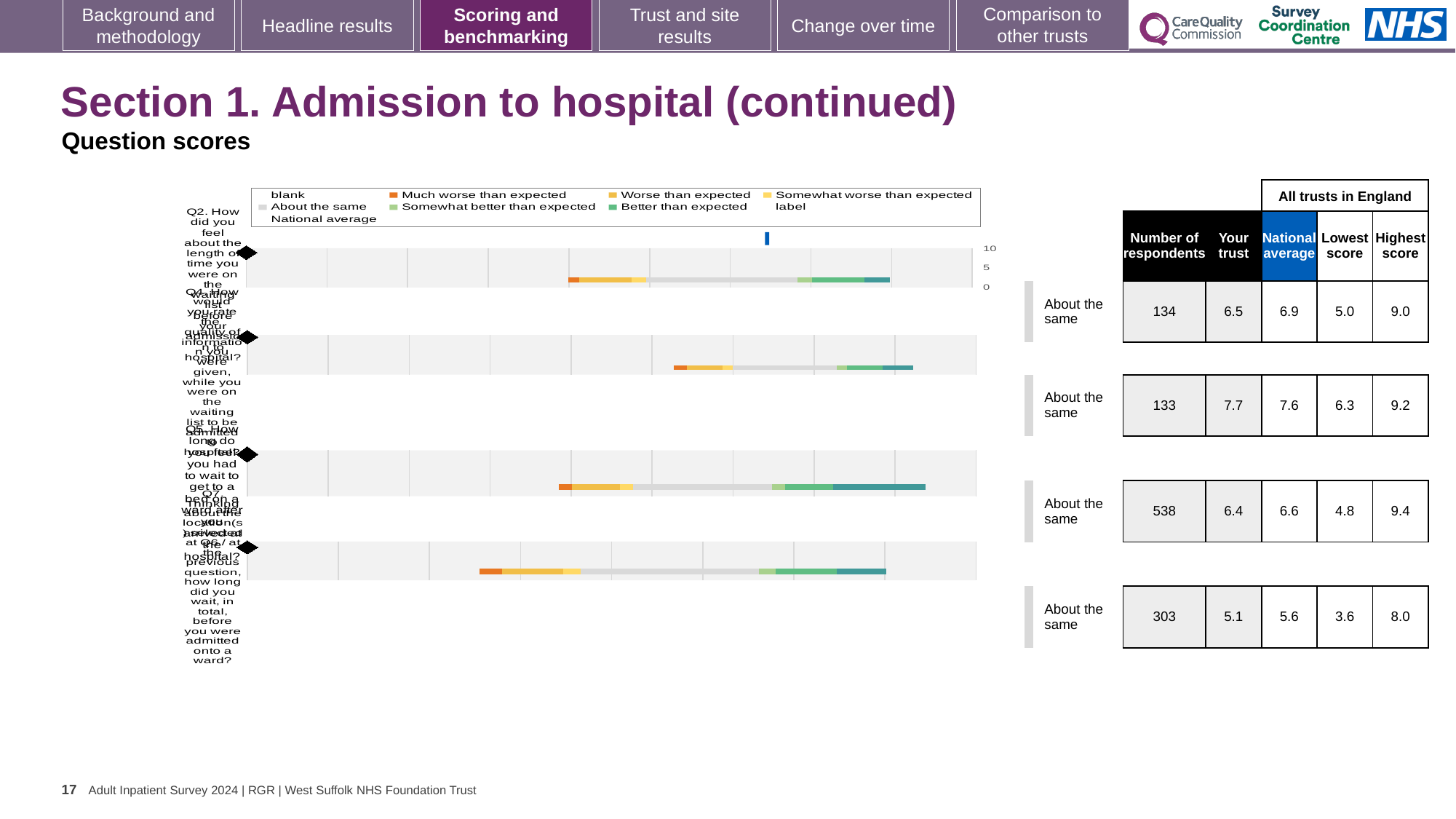
In the table beside the chart, what is the number of respondents for the first (top) question row? 134 What is the highest tick value shown on the chart's horizontal axis? 10 For the first question row, what is the difference between the national average and the 'Your trust' score? 0.4 How many question rows (bars) does the chart contain? 4 In the table beside the chart, what is the lowest score for the fourth (bottom) question row? 3.6 Which question row has the lowest 'Your trust' score in the table beside the chart? the fourth row (5.1) What kind of chart is shown on the slide? bar chart In the table beside the chart, what is the 'Your trust' score for the second question row? 7.7 Which question row has the highest 'Your trust' score in the table beside the chart? the second row (7.7) For the fourth question row, which is larger: the 'Your trust' score or the national average? national average In the table beside the chart, what is the highest score for the third question row? 9.4 What colour is the 'About the same' band in the chart's legend? grey